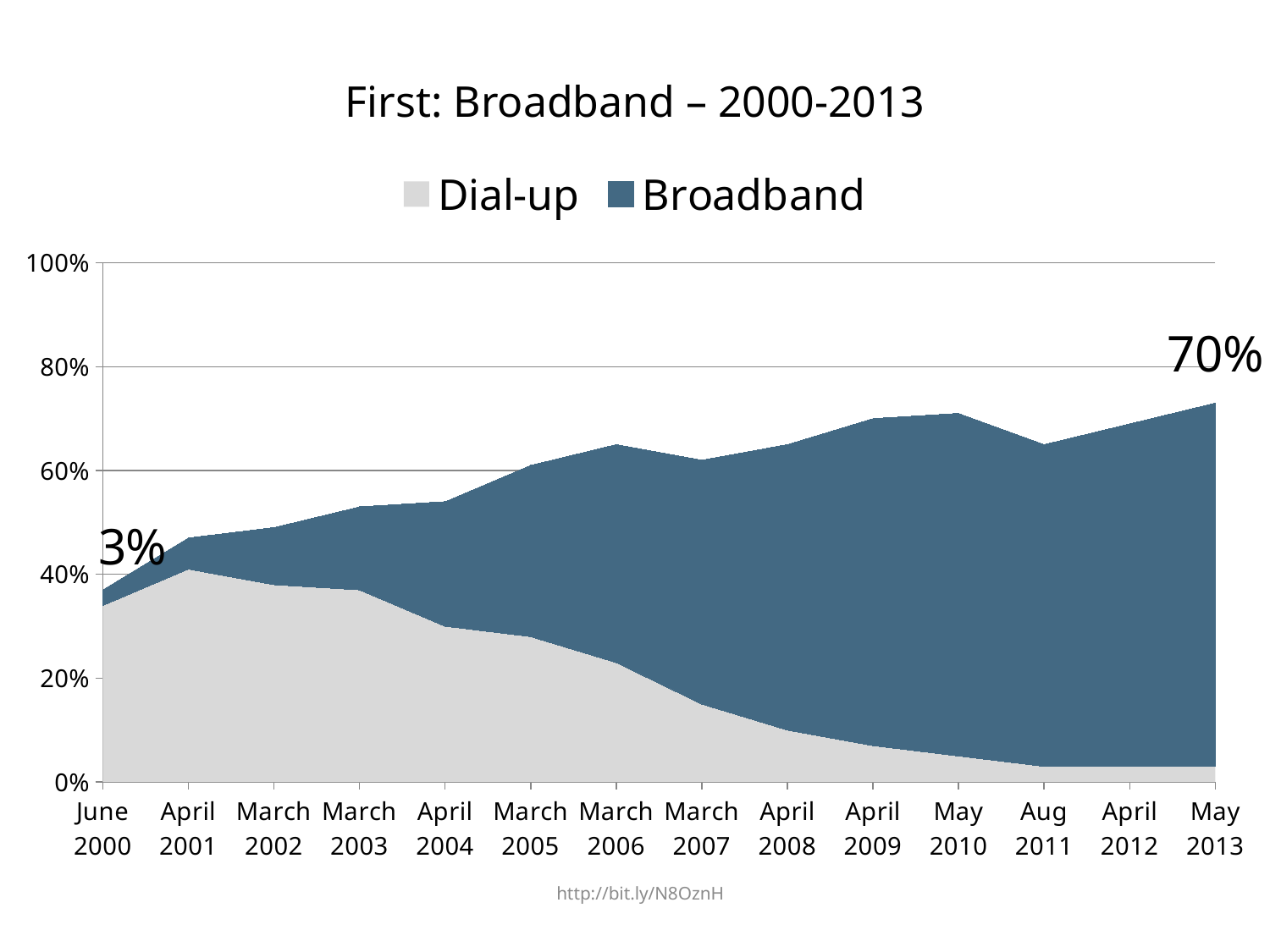
At which date is the Broadband value lowest? June 2000 In June 2000, which is larger: Dial-up or Broadband? Dial-up In May 2013, which is larger: Dial-up or Broadband? Broadband What is the Broadband value labelled for June 2000? 3% Is the Dial-up value for June 2000 greater or less than 20%? greater Is the Dial-up value for May 2013 greater or less than 20%? less At which date is the Broadband value highest? May 2013 How many series does the legend list? 2 By how many percentage points did the labelled Broadband value increase from June 2000 to May 2013? 67 percentage points What is the Broadband value labelled for May 2013? 70% How many dates are shown along the x axis? 14 What kind of chart is shown on the slide? Stacked area chart